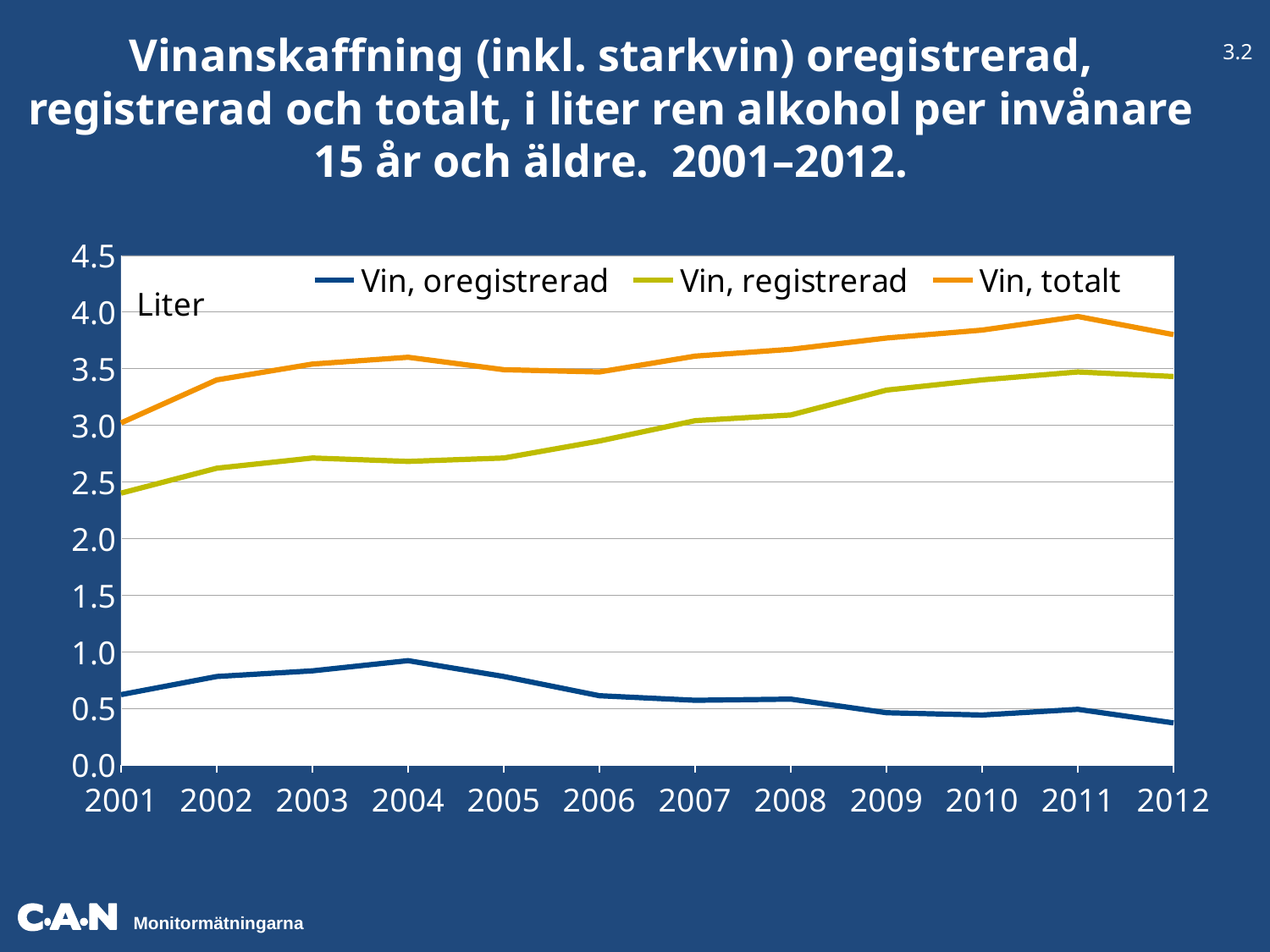
How many series does the legend list? 3 Is the value for 'Vin, totalt' in 2011 greater or less than 3.5? greater In which year is the 'Vin, registrerad' series at its lowest? 2001 Is the value for 'Vin, registrerad' in 2012 greater or less than 3.0? greater In which year does the 'Vin, oregistrerad' series reach its highest value? 2004 In which year does the 'Vin, totalt' series reach its highest value? 2011 What kind of chart is shown on the slide? line chart Which is larger in 2012, 'Vin, registrerad' or 'Vin, oregistrerad'? Vin, registrerad What unit label is shown at the top of the y axis? Liter How many years are plotted along the x axis? 12 Does the 'Vin, oregistrerad' series rise or fall from 2004 to 2012? fall Is the value for 'Vin, oregistrerad' in 2004 greater or less than 1.0? less